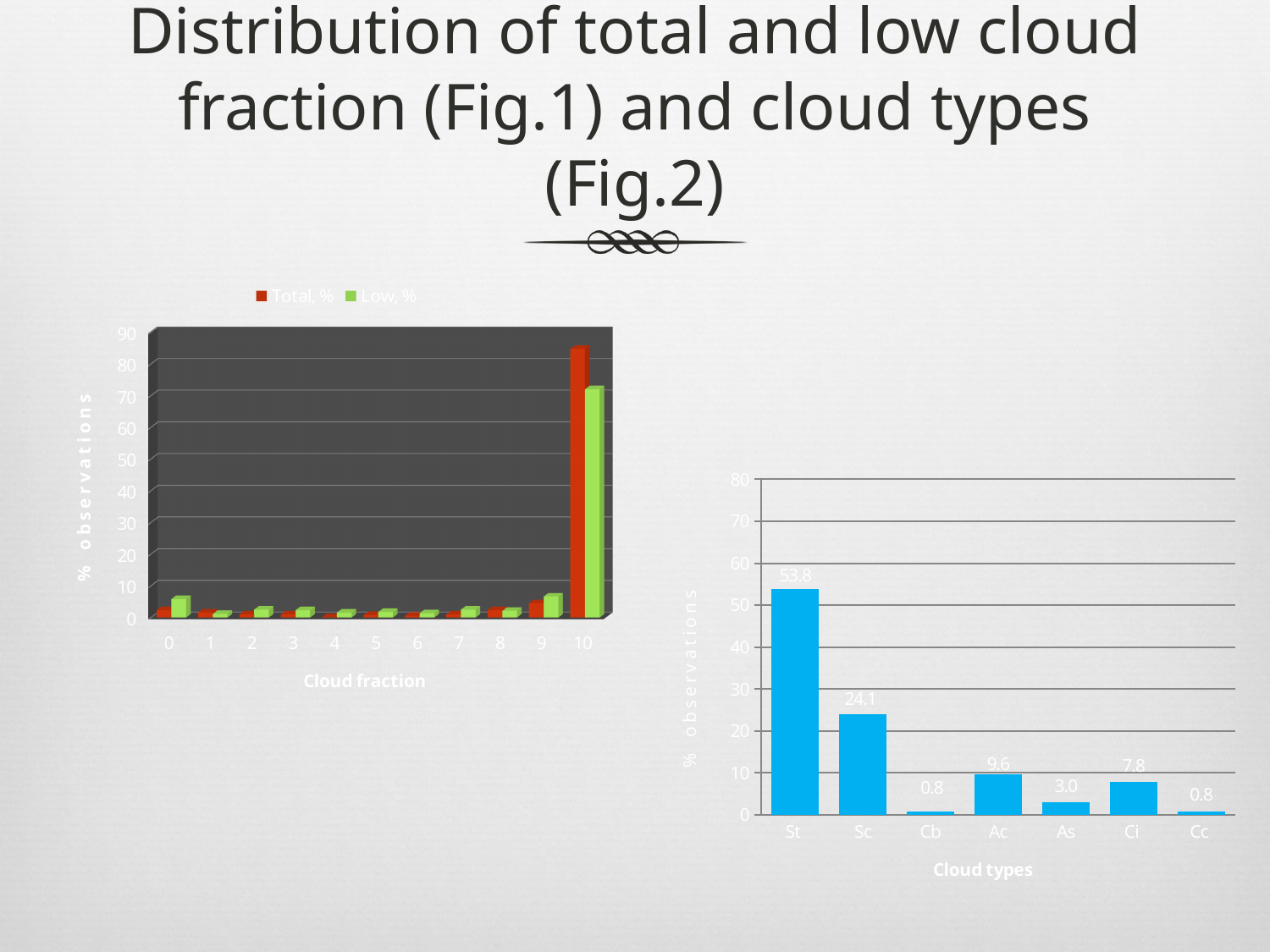
In the right chart (Cloud types), what is the value for St? 53.8 In the left chart (Cloud fraction), is the value of Total, % for cloud fraction 10 greater or less than 80? greater In the right chart (Cloud types), what is the value for Ac? 9.6 In the right chart (Cloud types), what is the difference between the values for St and Sc? 29.7 In the right chart (Cloud types), how many cloud types are shown on the x axis? 7 What kind of chart is the right chart (Cloud types)? bar chart In the right chart (Cloud types), which is larger, the value for Ac or the value for Ci? Ac In the right chart (Cloud types), which cloud type has the highest value? St In the left chart (Cloud fraction), how many series does the legend list? 2 In the left chart (Cloud fraction), which cloud fraction has the highest value for Total, %? 10 In the left chart (Cloud fraction), how many cloud fraction categories are shown on the x axis? 11 In the right chart (Cloud types), what is the value for Sc? 24.1